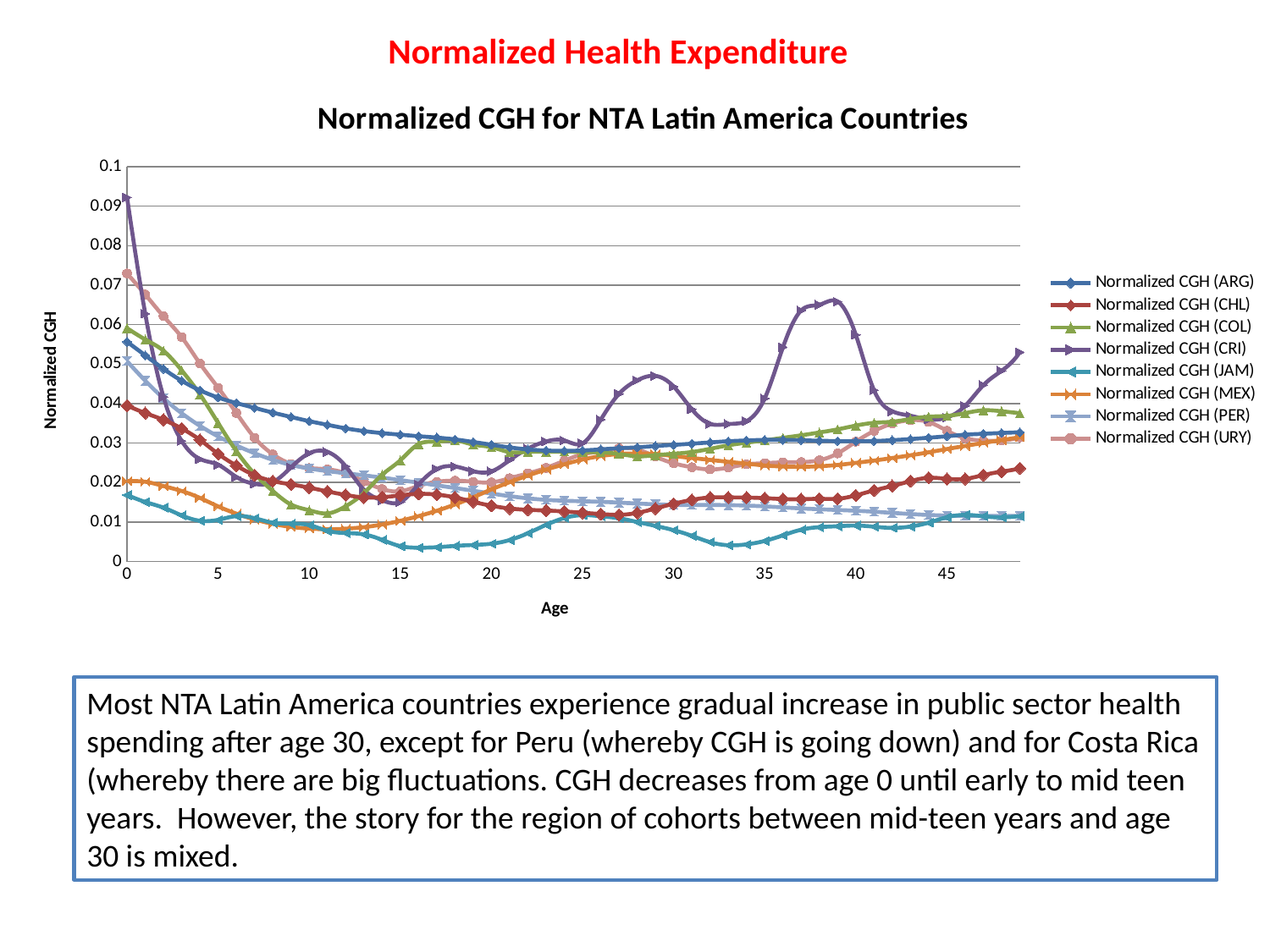
Is the value for Normalized CGH (URY) at age 0 greater or less than 0.06? greater Does the Normalized CGH (JAM) line rise or fall from age 0 to age 15? fall What kind of chart is shown on the slide? line chart How many series does the legend list? 8 Which country has the highest Normalized CGH at age 0? CRI What is the title of the chart? Normalized CGH for NTA Latin America Countries What is the label on the x axis of the chart? Age Which country has the lowest Normalized CGH at age 0? JAM Is the value for Normalized CGH (JAM) at age 15 greater or less than 0.01? less At age 38, which is larger: Normalized CGH (CRI) or Normalized CGH (ARG)? Normalized CGH (CRI) Which country has the highest Normalized CGH at the right end of the chart (age 49)? CRI Is the value for Normalized CGH (CRI) at age 0 greater or less than 0.08? greater